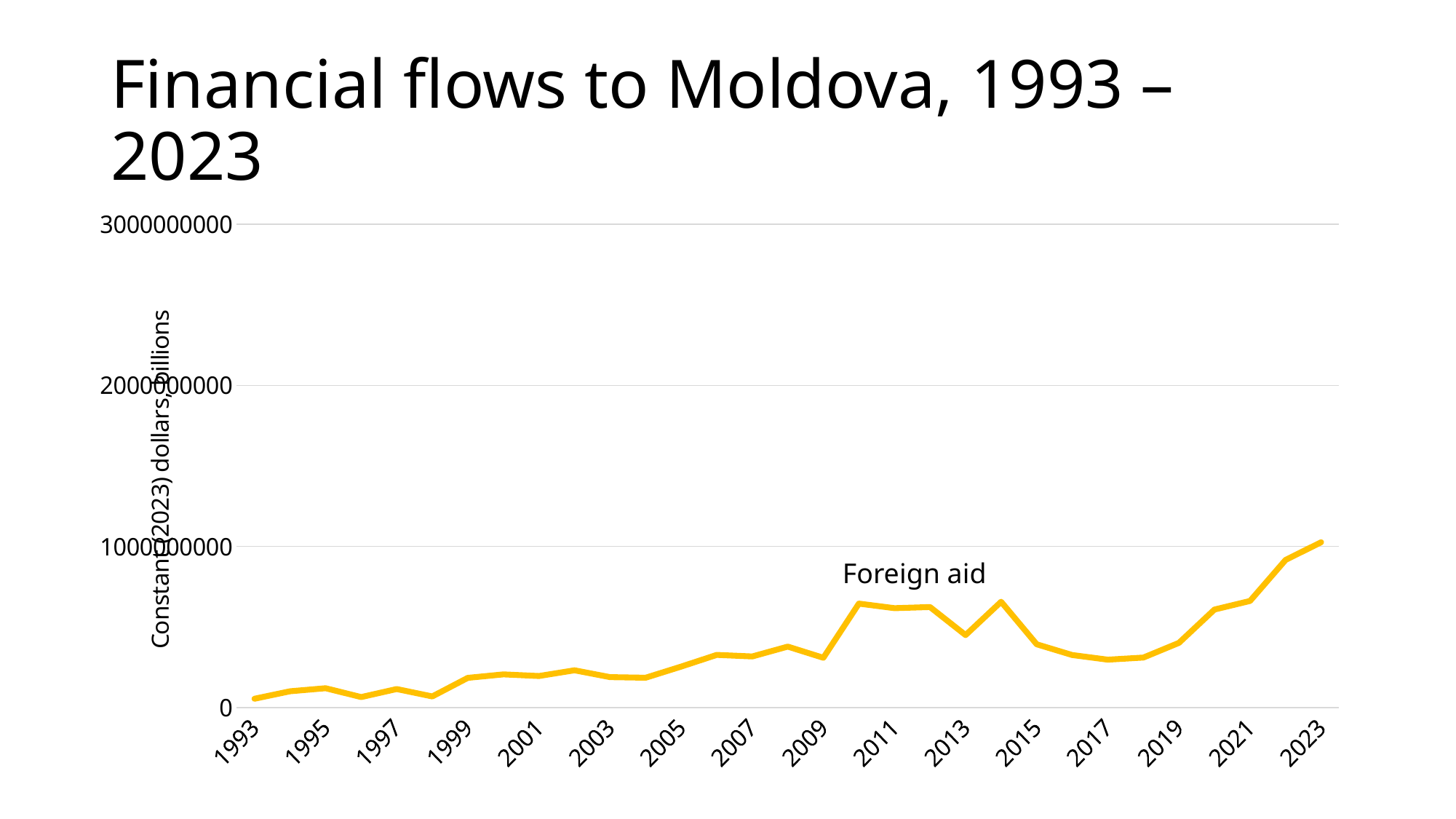
Which year has the larger Foreign aid value, 2009 or 2010? 2010 What is the name of the series plotted on the chart? Foreign aid How many series are plotted on the chart? 1 What is the title of the chart on the slide? Financial flows to Moldova, 1993 – 2023 Is the value for Foreign aid in 2010 greater or less than 1000000000? less Is the value for Foreign aid in 1993 greater or less than 1000000000? less In which year does the Foreign aid line reach its highest value? 2023 How many year labels are shown on the x axis? 16 What kind of chart is shown on the slide? line chart Overall, does the Foreign aid line rise or fall from 1993 to 2023? rise Which year has the larger Foreign aid value, 2017 or 2023? 2023 Is the value for Foreign aid in 2023 greater or less than 2000000000? less